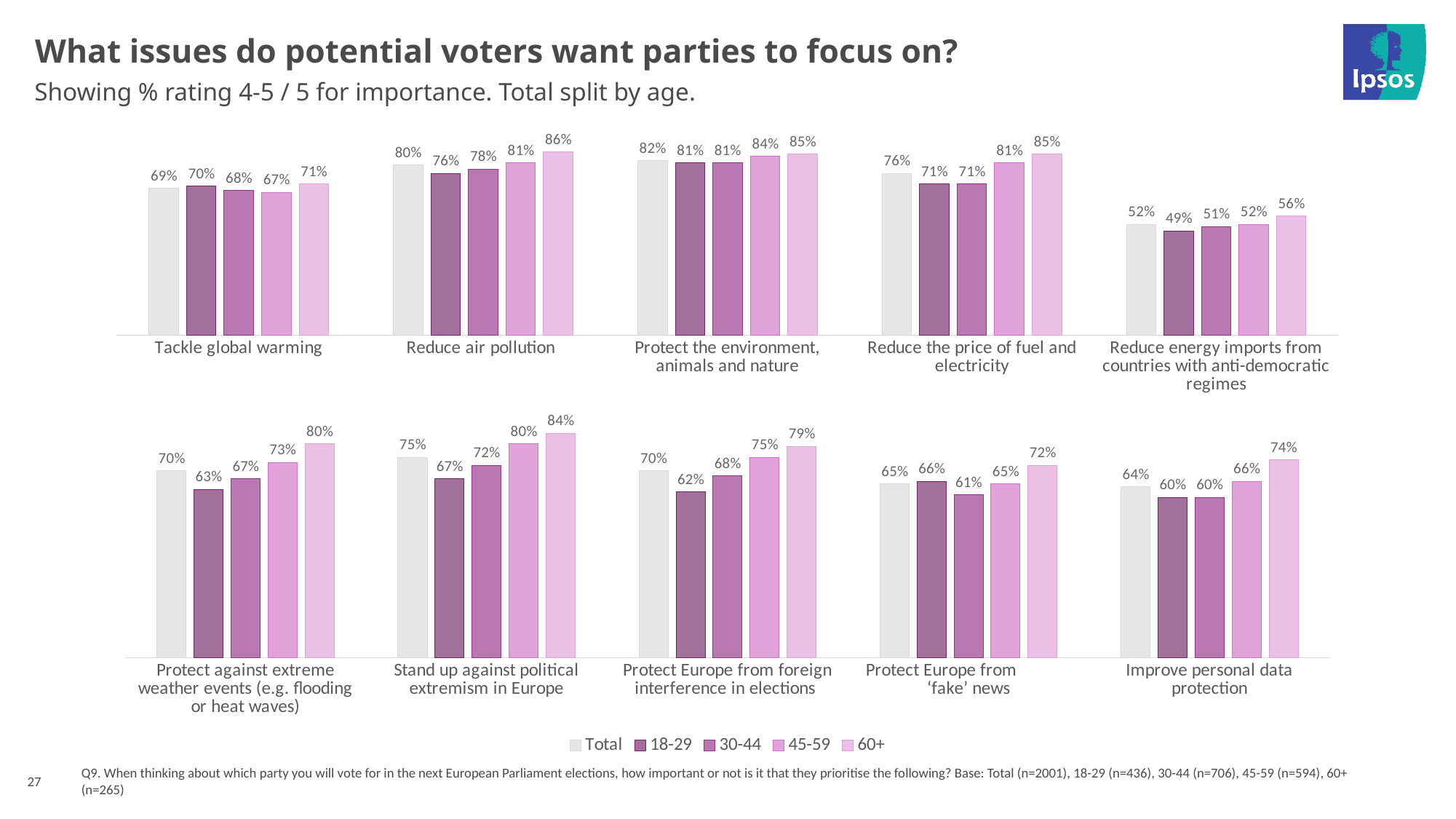
In the bottom chart, which is larger for Improve personal data protection: the 45-59 value or the 30-44 value? 45-59 Which legend entry is shown in light grey? Total In the top chart, what is the Total value for Reduce air pollution? 80% In the top chart, what is the difference between the 60+ and 18-29 values for Reduce the price of fuel and electricity? 14% How many series does the legend list? 5 In the top chart, which category has the lowest Total value? Reduce energy imports from countries with anti-democratic regimes In the bottom chart, what is the difference between the Total and 18-29 values for Protect against extreme weather events (e.g. flooding or heat waves)? 7% What kind of chart is used on this slide? Bar chart In the bottom chart, what is the 18-29 value for Protect Europe from foreign interference in elections? 62% In the bottom chart, which category has the highest 60+ value? Stand up against political extremism in Europe In the top chart, what is the 60+ value for Reduce the price of fuel and electricity? 85% How many categories are shown in the bottom chart? 5